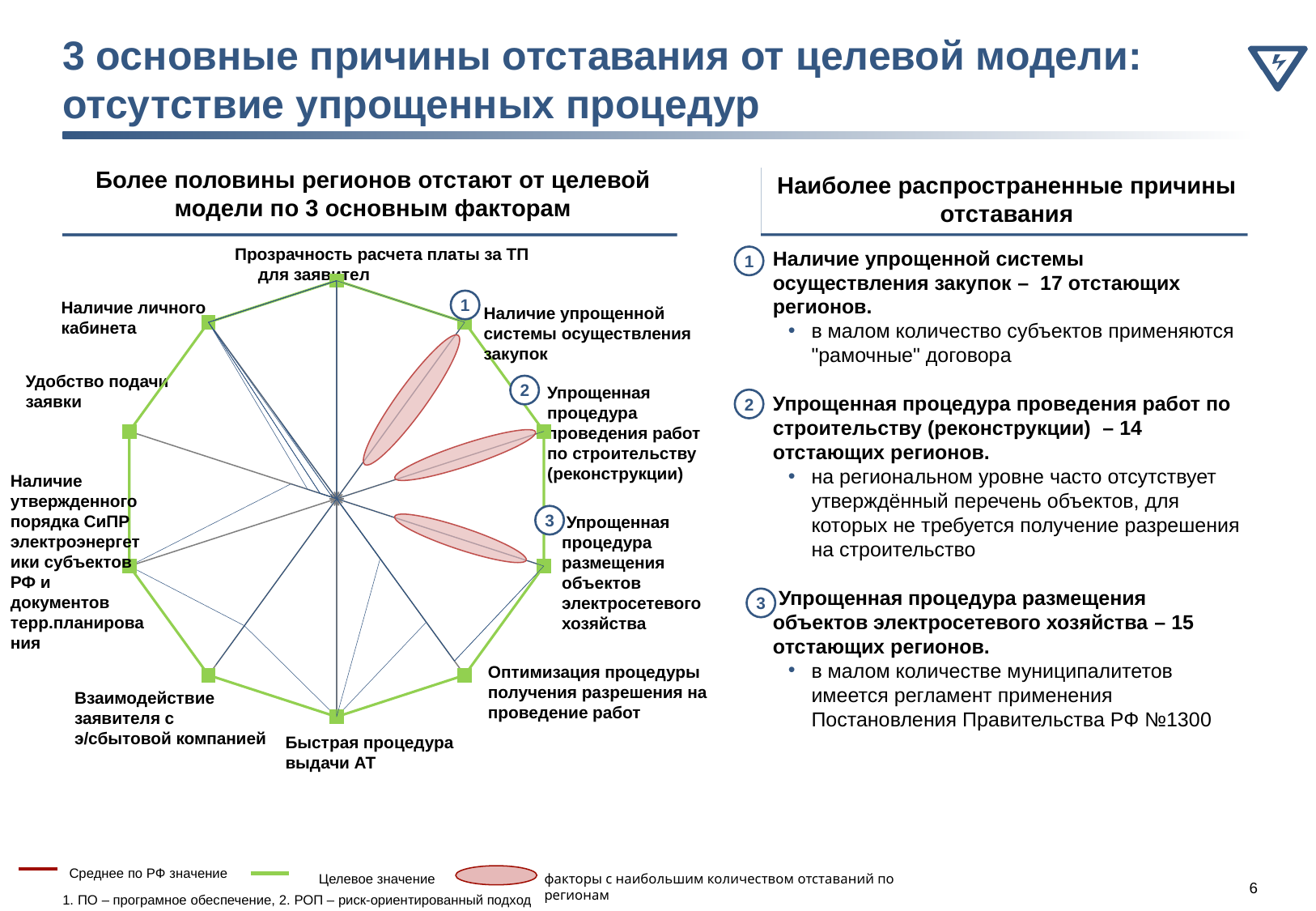
What is the difference between the number of lagging regions for factor 1 (17) and factor 2 (14)? 3 Of the three highlighted factors, which has the largest number of lagging regions? Наличие упрощенной системы осуществления закупок Of the three highlighted factors, which has the smallest number of lagging regions? Упрощенная процедура проведения работ по строительству (реконструкции) According to the slide, how many regions lag behind on the factor 'Наличие упрощенной системы осуществления закупок'? 17 What kind of chart is shown on the left side of the slide? Radar chart According to the slide, how many regions lag behind on the factor 'Упрощенная процедура размещения объектов электросетевого хозяйства'? 15 Which has more lagging regions: factor 2 (construction works procedure) or factor 3 (placement of grid facilities)? Factor 3 (15) How many data series does the chart legend list (excluding the ellipse marker)? 2 Which factor on the radar chart is marked with the number 1? Наличие упрощенной системы осуществления закупок How many factors (axes) does the radar chart have? 10 According to the slide, how many regions lag behind on the factor 'Упрощенная процедура проведения работ по строительству (реконструкции)'? 14 Which colour represents 'Целевое значение' in the chart legend? Green